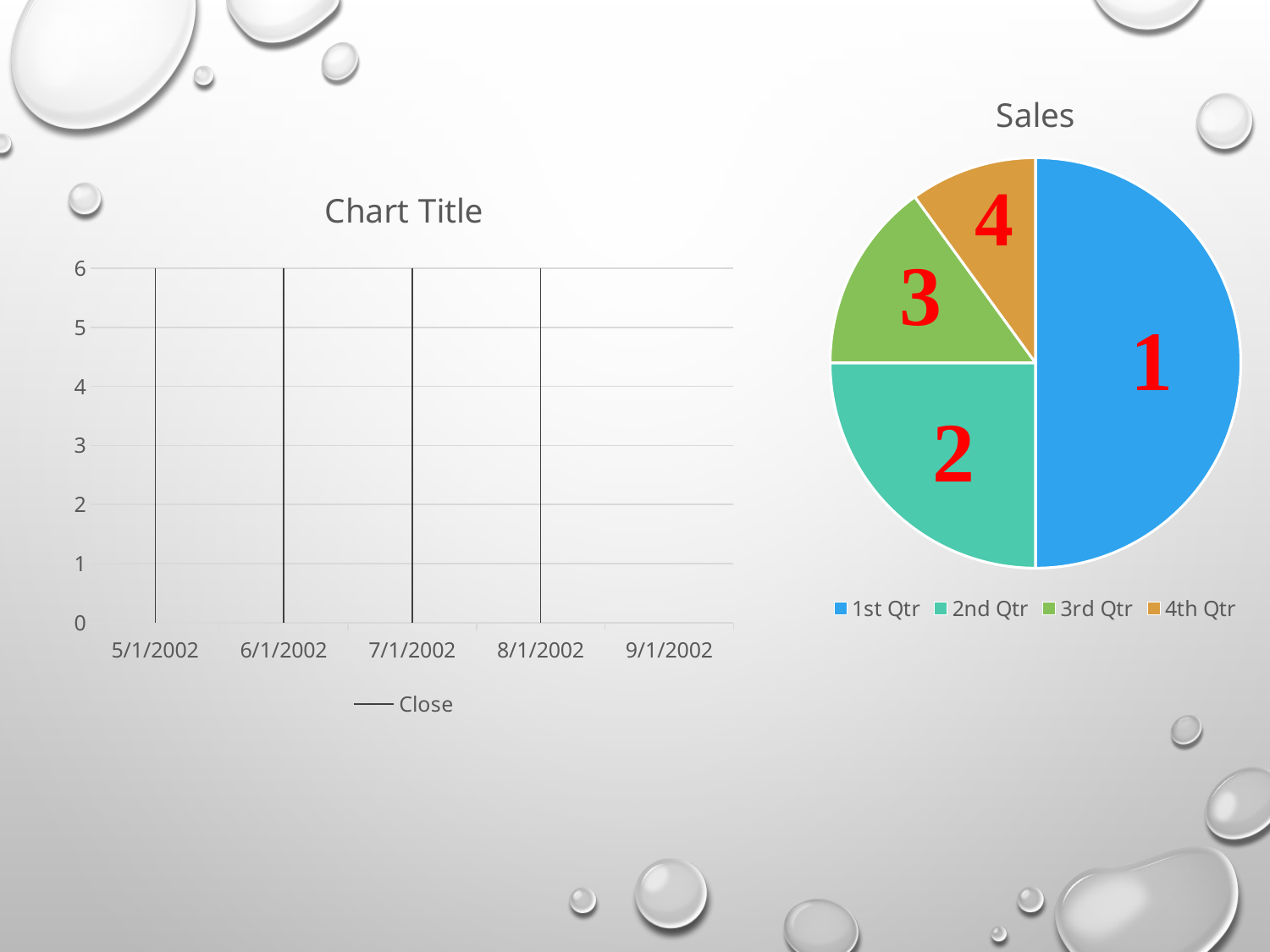
In the "Sales" pie chart, what colour is the 1st Qtr slice? Blue How many slices does the "Sales" pie chart have? 4 How many series does the legend of the chart titled "Chart Title" list? 1 In the "Sales" pie chart, which quarter has the smallest slice? 4th Qtr In the chart titled "Chart Title", what is the name of the series shown in the legend? Close In the "Sales" pie chart, which slice is larger: 3rd Qtr or 4th Qtr? 3rd Qtr How many dates are labelled on the x axis of the chart titled "Chart Title"? 5 What kind of chart is the chart titled "Sales"? Pie chart In the "Sales" pie chart, which quarter has the largest slice? 1st Qtr What is the title of the chart on the right side of the slide? Sales In the "Sales" pie chart, which slice is larger: 2nd Qtr or 3rd Qtr? 2nd Qtr